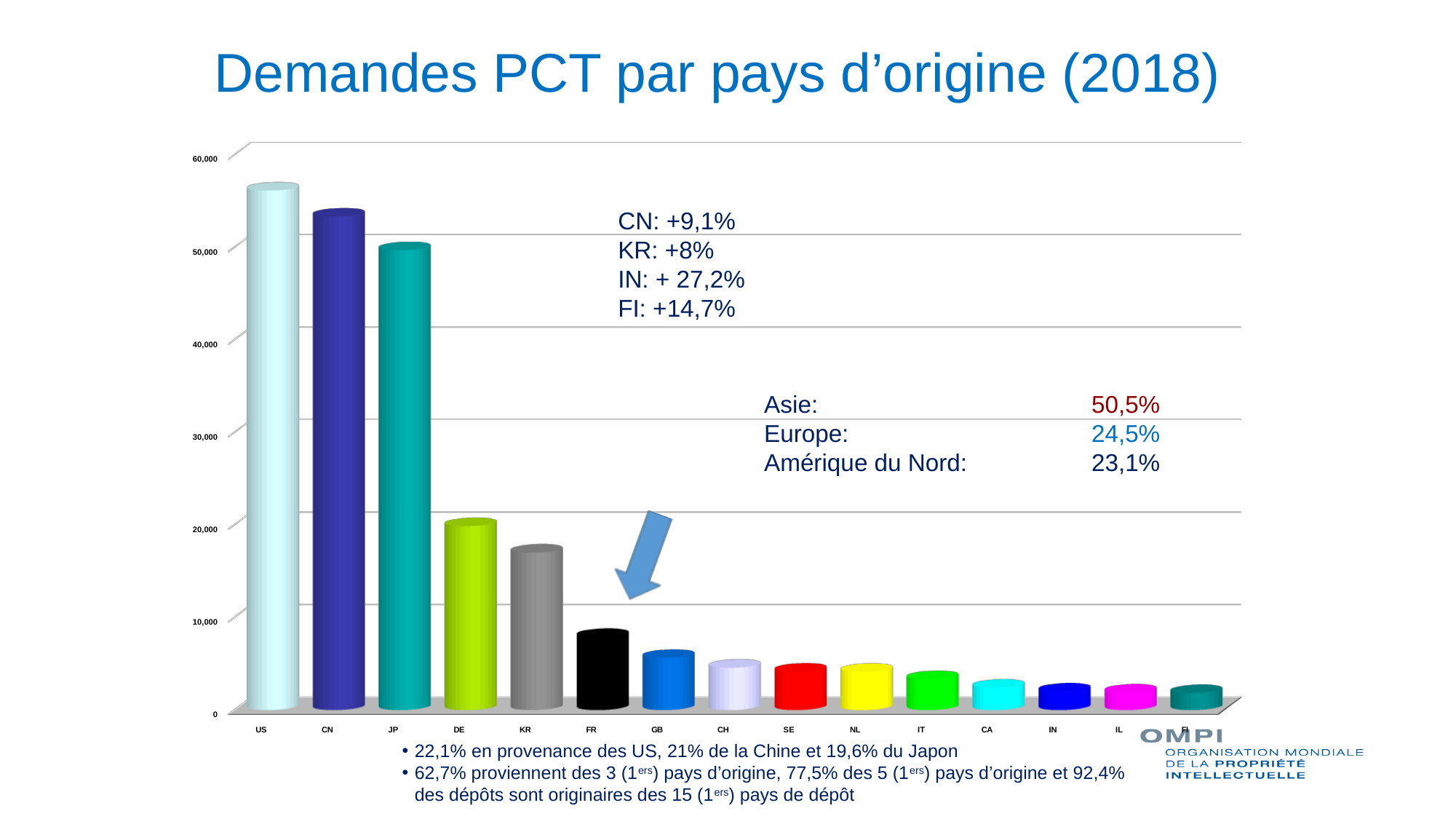
Do the bar values rise or fall moving from left to right along the x axis? fall How many countries (bars) are plotted in the chart? 15 Which has the larger value, FR or GB? FR Is the value for US greater or less than 50,000? greater Is the value for KR greater or less than 20,000? less Is the value for KR greater or less than 10,000? greater Which has the larger value, JP or DE? JP What kind of chart is shown on the slide? bar chart Which has the larger value, DE or KR? DE Which country has the highest bar in the chart? US What is the title of the slide's chart? Demandes PCT par pays d'origine (2018)